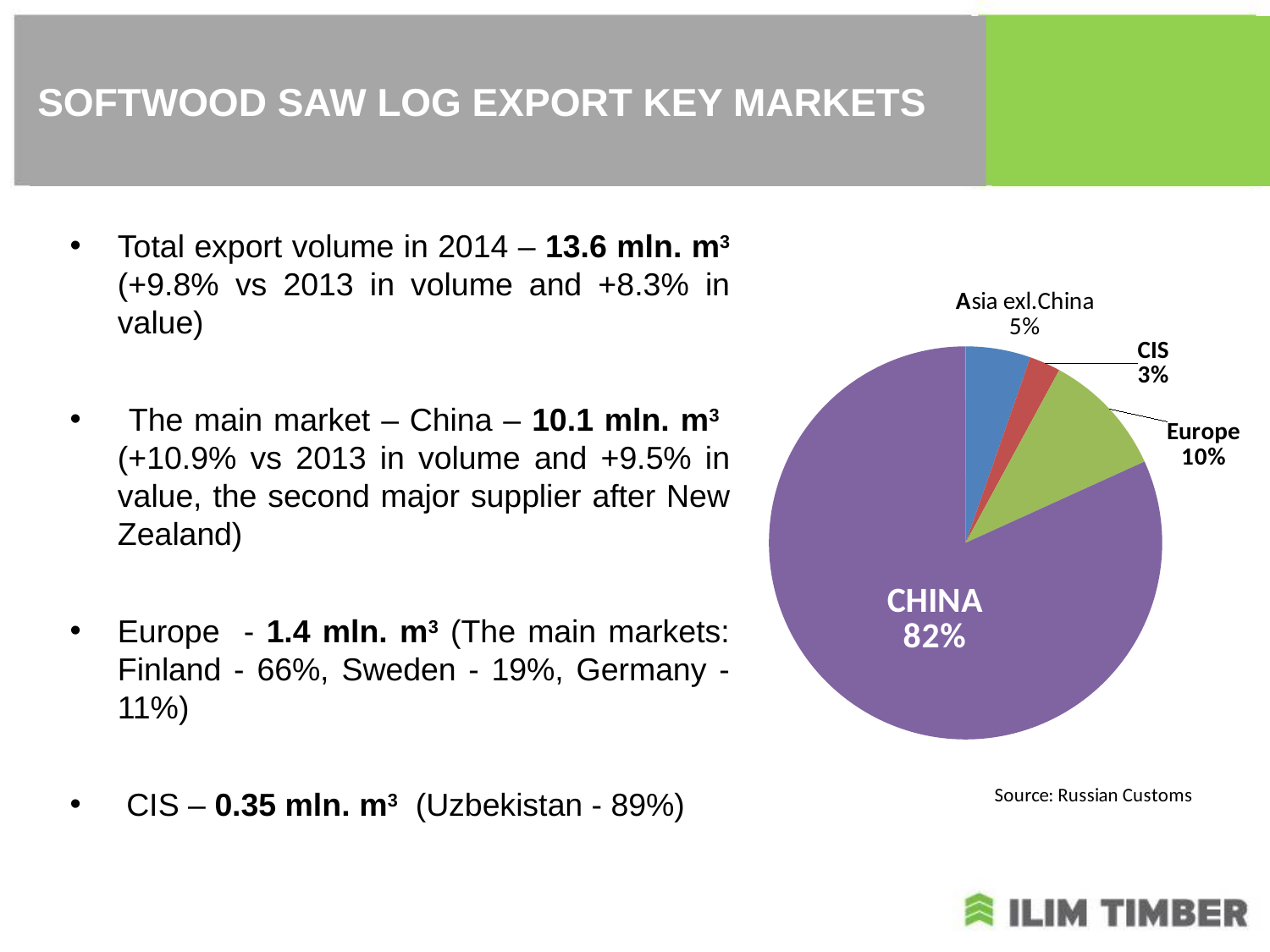
Which slice of the pie chart is the smallest? CIS Which slice is larger, Asia exl.China or CIS? Asia exl.China What share of the pie chart does China account for? 82% What share of the pie chart does Europe account for? 10% What share of the pie chart does Asia exl.China account for? 5% Which slice of the pie chart is the largest? CHINA What type of chart is shown on the slide? Pie chart What share of the pie chart does CIS account for? 3% What is the difference in percentage points between the China slice and the Europe slice? 72 How many slices does the pie chart have? 4 What is the difference in percentage points between the Europe slice and the Asia exl.China slice? 5 What colour is the China slice in the pie chart? Purple